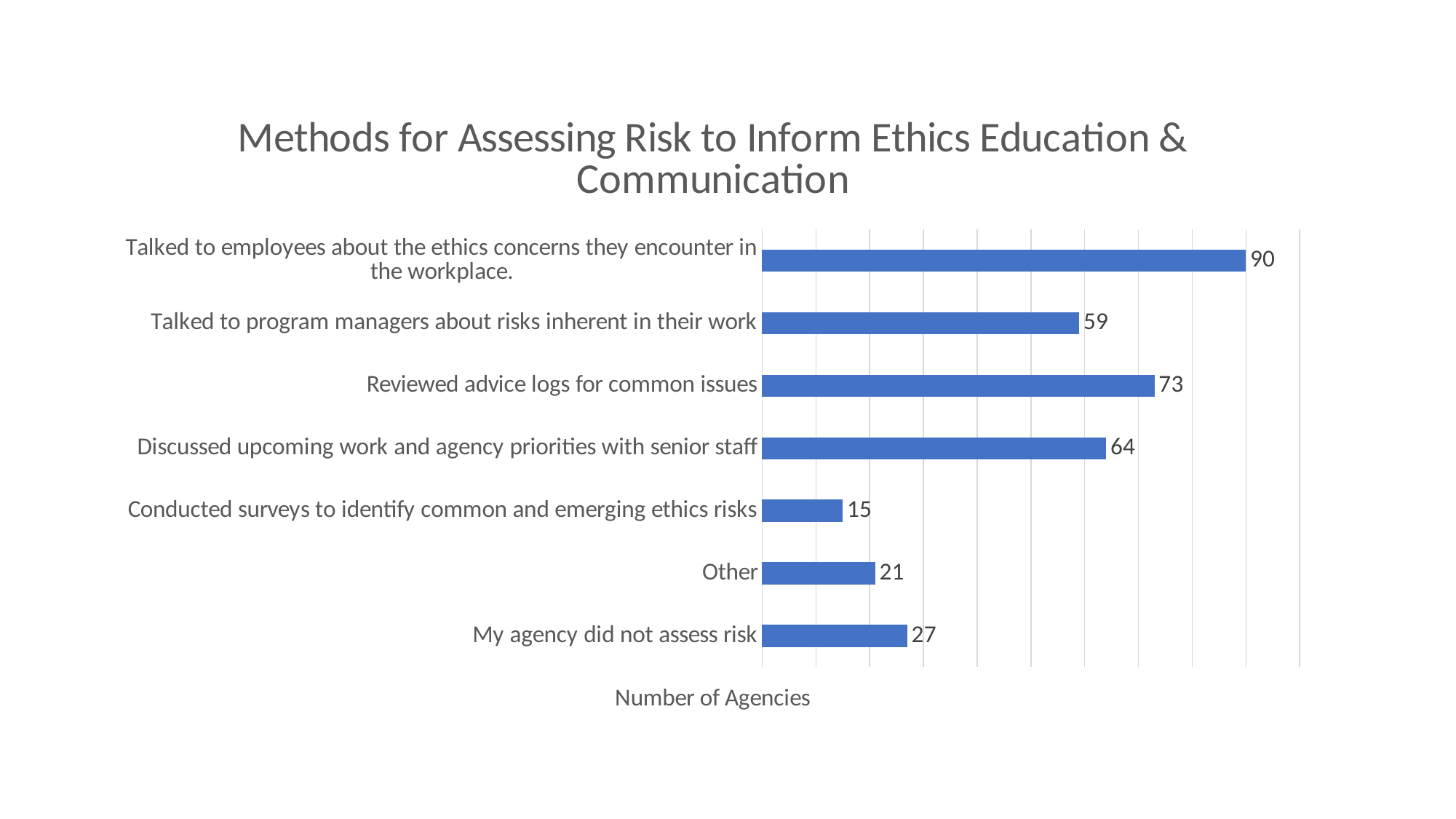
What is the value for 'Reviewed advice logs for common issues'? 73 What kind of chart is shown on the slide? Bar chart What is the difference between the number of agencies that reviewed advice logs for common issues and those that talked to program managers about risks inherent in their work? 14 What is the label of the horizontal axis? Number of Agencies How many agencies conducted surveys to identify common and emerging ethics risks? 15 Which method has the highest number of agencies? Talked to employees about the ethics concerns they encounter in the workplace. What is the title of the chart? Methods for Assessing Risk to Inform Ethics Education & Communication What is the value for 'My agency did not assess risk'? 27 Which category has the lowest number of agencies? Conducted surveys to identify common and emerging ethics risks Which has more agencies: 'Discussed upcoming work and agency priorities with senior staff' or 'Talked to program managers about risks inherent in their work'? Discussed upcoming work and agency priorities with senior staff How many categories are shown in the chart? 7 How many agencies talked to employees about the ethics concerns they encounter in the workplace? 90